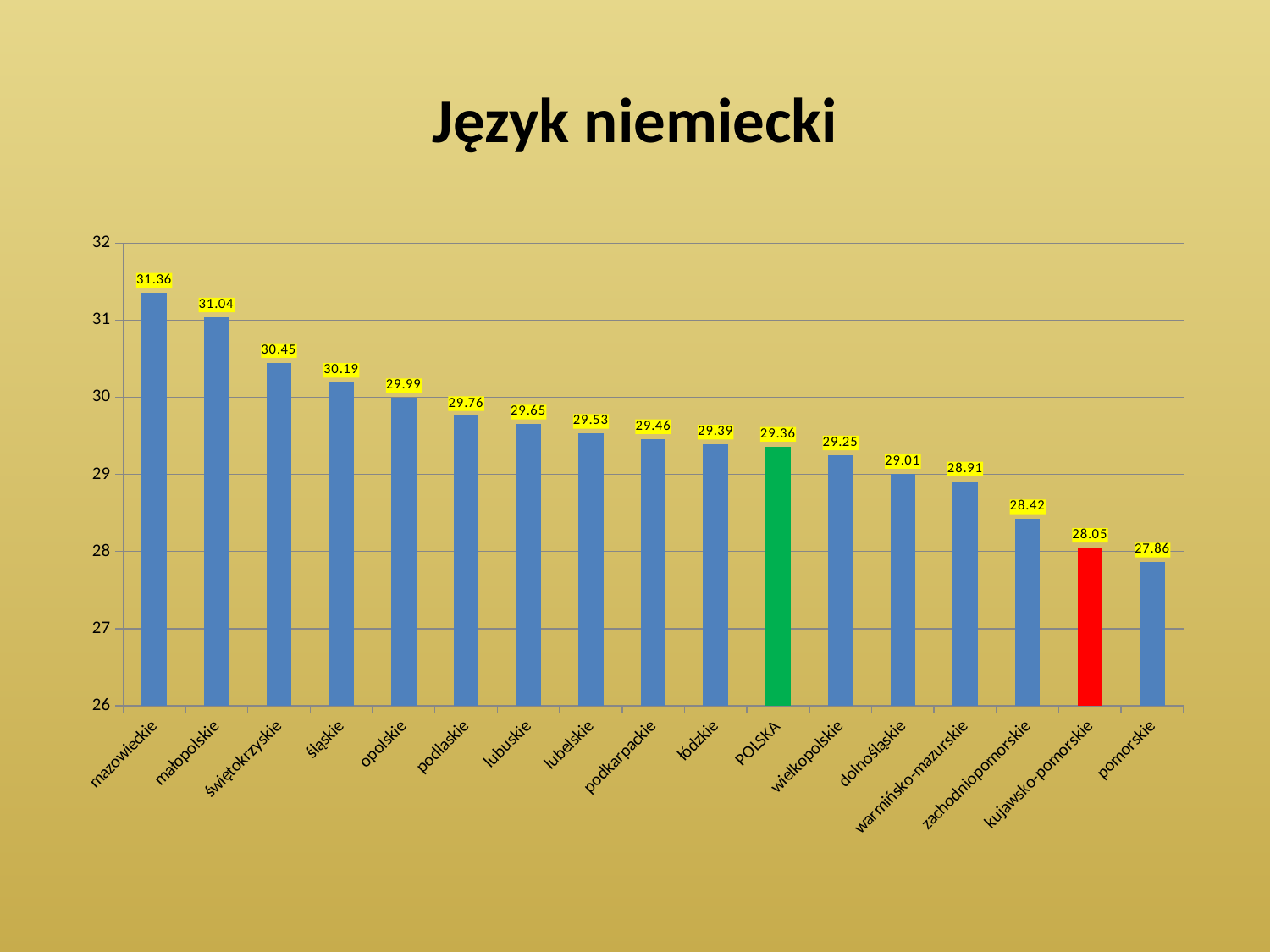
Which category has the highest value? mazowieckie What is the difference between the values for mazowieckie and pomorskie? 3.50 Which is larger, the value for śląskie or the value for dolnośląskie? śląskie What is the value for mazowieckie? 31.36 Do the values rise or fall from left to right along the x axis? fall What is the difference between the values for małopolskie and POLSKA? 1.68 What is the value for POLSKA? 29.36 What kind of chart is shown on the slide? bar chart Which category has the lowest value? pomorskie How many categories are shown on the x axis? 17 What is the value for warmińsko-mazurskie? 28.91 What is the value for kujawsko-pomorskie? 28.05